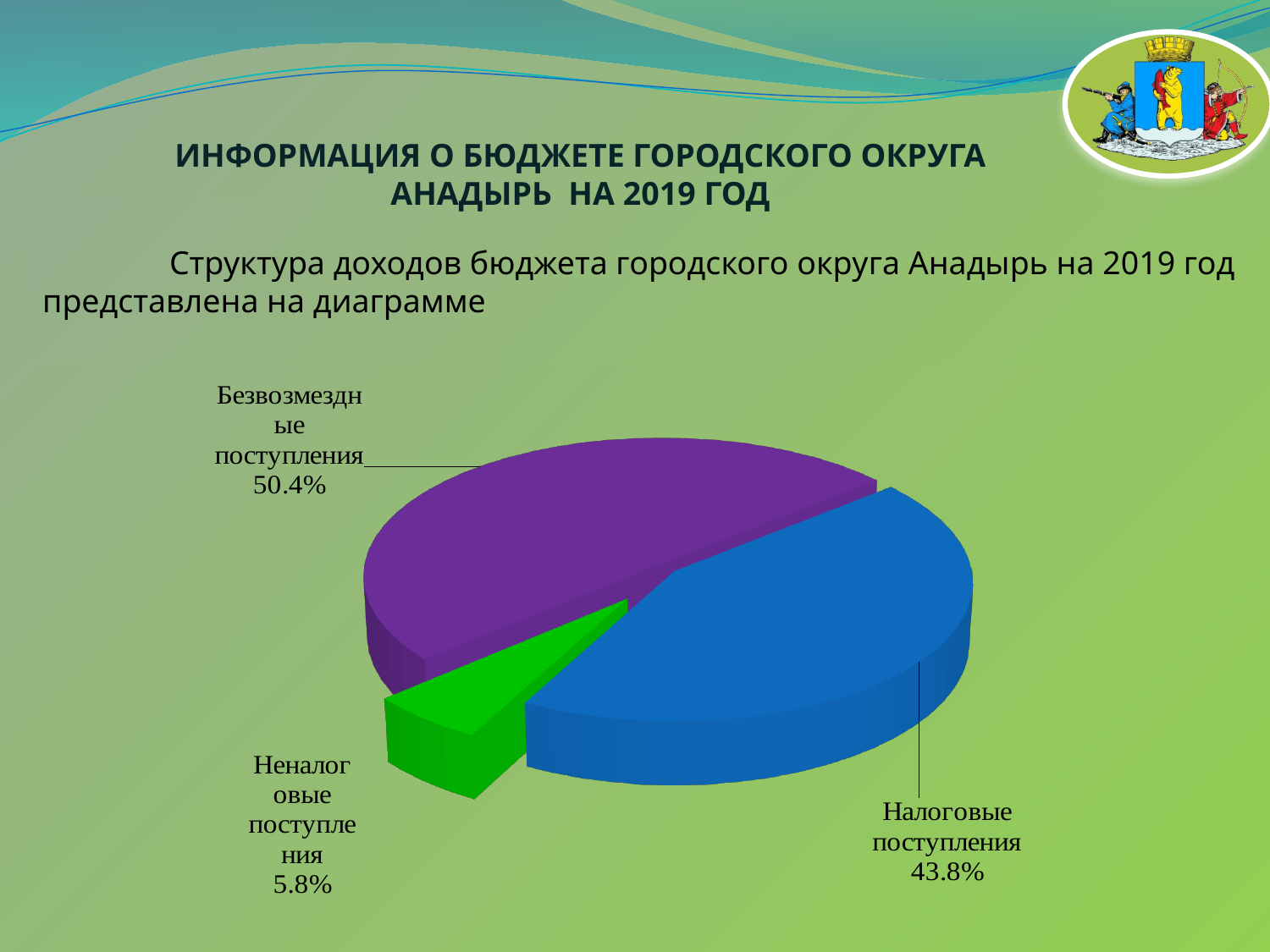
What colour is the slice for Неналоговые поступления? green What colour is the slice for Налоговые поступления? blue What share of the pie is labelled Безвозмездные поступления? 50.4% Which is larger, Налоговые поступления or Неналоговые поступления? Налоговые поступления What is the difference in percentage points between Налоговые поступления and Неналоговые поступления? 38 How many slices does the pie chart have? 3 Which slice of the pie chart is the largest? Безвозмездные поступления Which slice of the pie chart is the smallest? Неналоговые поступления What is the difference in percentage points between Безвозмездные поступления and Налоговые поступления? 6.6 What share of the pie is labelled Налоговые поступления? 43.8% What kind of chart is shown on the slide? pie chart What share of the pie is labelled Неналоговые поступления? 5.8%